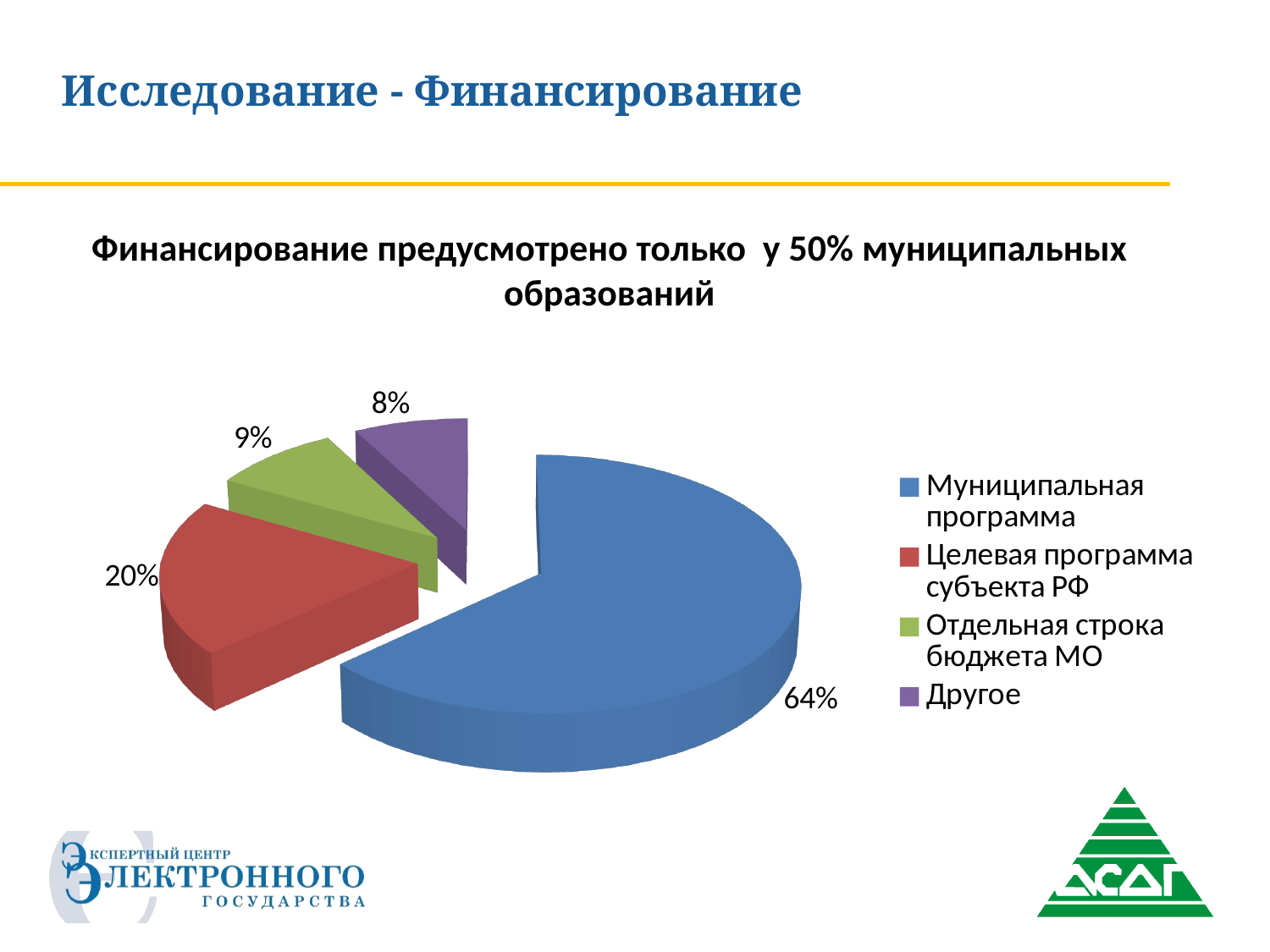
What colour is the slice for 'Другое'? purple What share of the pie does 'Муниципальная программа' have? 64% Which category has the smallest slice of the pie? Другое What is the value for 'Другое'? 8% Which is larger, the value for 'Целевая программа субъекта РФ' or the value for 'Отдельная строка бюджета МО'? Целевая программа субъекта РФ What is the value for 'Целевая программа субъекта РФ'? 20% Which category has the largest slice of the pie? Муниципальная программа What is the difference between the values for 'Муниципальная программа' and 'Целевая программа субъекта РФ'? 44% What is the value for 'Отдельная строка бюджета МО'? 9% How many categories does the legend list? 4 What is the title of the chart? Финансирование предусмотрено только у 50% муниципальных образований What kind of chart is shown on the slide? pie chart